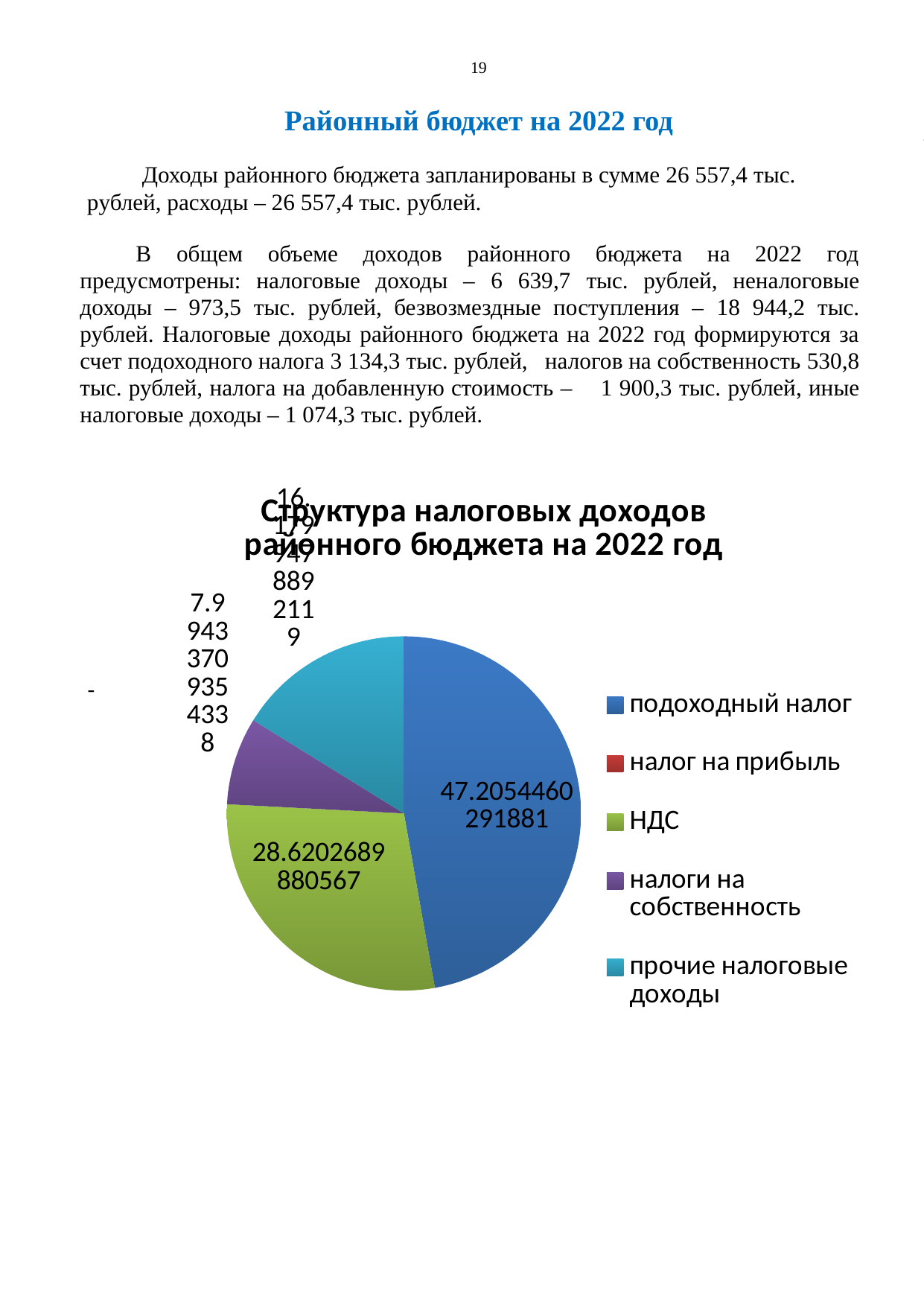
What value is shown for подоходный налог? 47.2054460291881 How many categories does the chart legend list? 5 Which is larger, the slice for НДС or the slice for налоги на собственность? НДС What is the difference between the values for подоходный налог and НДС? 18.5851770411314 What colour is the slice for подоходный налог? blue What is the title of the chart? Структура налоговых доходов районного бюджета на 2022 год Which is larger, the slice for прочие налоговые доходы or the slice for налоги на собственность? прочие налоговые доходы What kind of chart is shown on the slide? pie chart Which legend entry is shown in green? НДС What value is shown for НДС? 28.6202689880567 Which category has the largest slice of the pie? подоходный налог